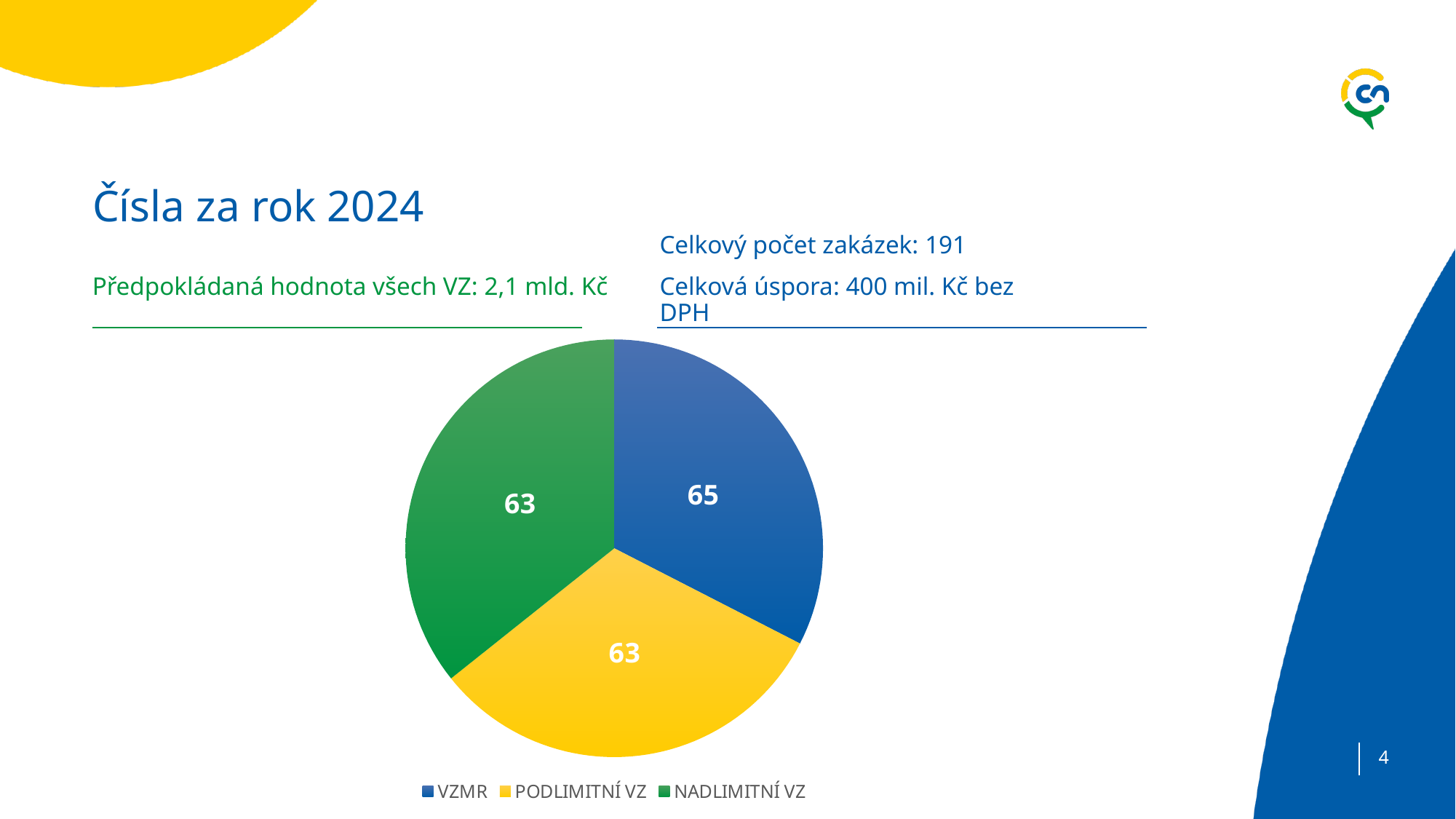
What colour is the VZMR slice in the pie chart? blue How many slices does the pie chart have? 3 What is the difference between the VZMR value and the PODLIMITNÍ VZ value in the pie chart? 2 What value is shown for the NADLIMITNÍ VZ slice of the pie chart? 63 What is the total of all three slice values in the pie chart? 191 Which category has the highest value in the pie chart? VZMR How many entries does the legend of the pie chart list? 3 What value is shown for the VZMR slice of the pie chart? 65 Which legend entry is shown in yellow in the pie chart? PODLIMITNÍ VZ What value is shown for the PODLIMITNÍ VZ slice of the pie chart? 63 Which is larger in the pie chart, VZMR or NADLIMITNÍ VZ? VZMR What kind of chart is shown on the slide? pie chart